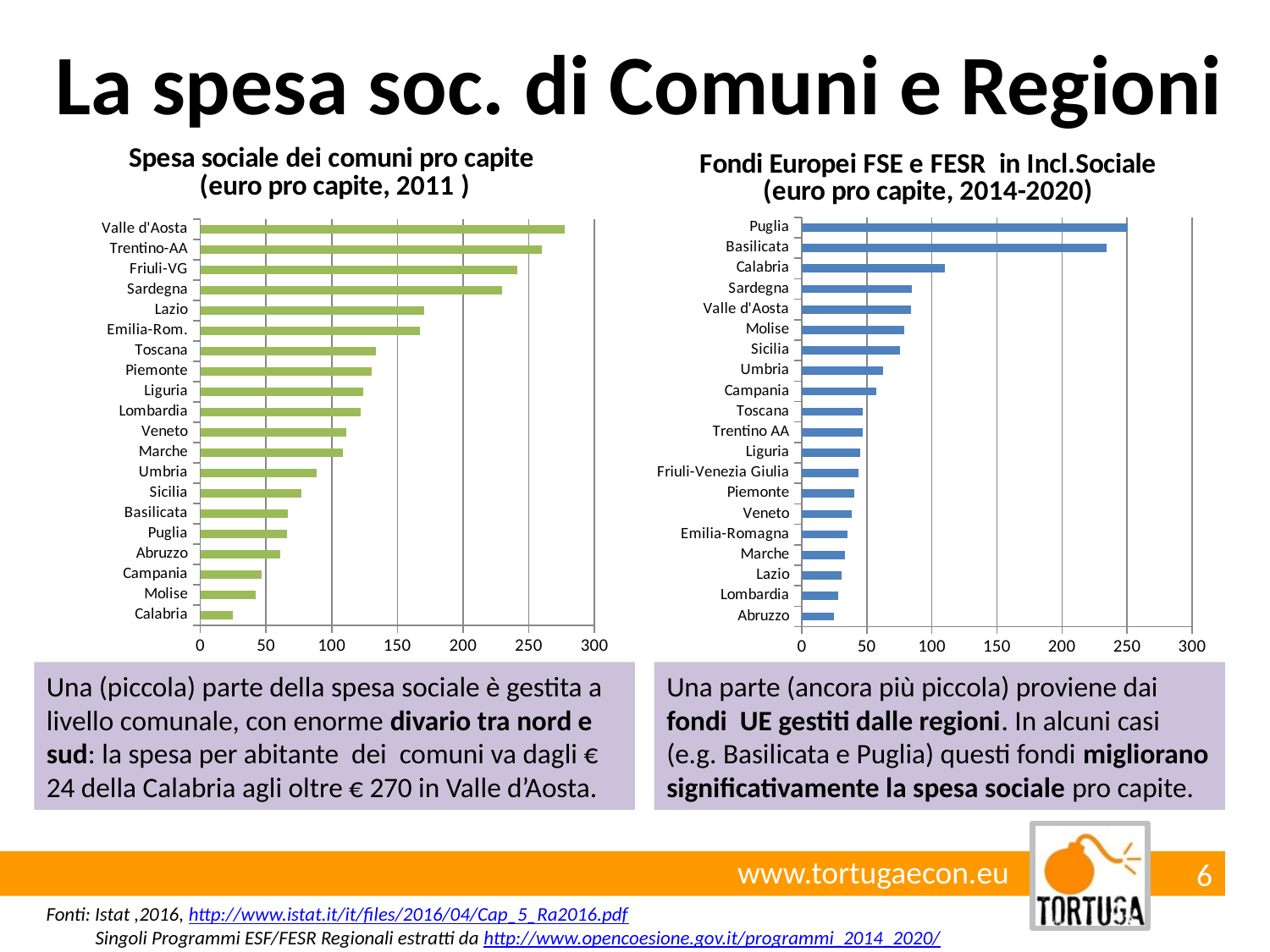
On the left chart (Spesa sociale dei comuni pro capite), which region has the highest value? Valle d'Aosta What kind of chart is the right chart (Fondi Europei FSE e FESR in Incl.Sociale)? Bar chart On the right chart (Fondi Europei FSE e FESR in Incl.Sociale), which region has the highest value? Puglia On the left chart, which has the larger value, Sardegna or Lazio? Sardegna On the right chart, is the value for Calabria greater or less than 100? greater On the left chart, is the value for Valle d'Aosta greater or less than 250? greater On the right chart, which has the larger value, Calabria or Sardegna? Calabria On the right chart (Fondi Europei FSE e FESR in Incl.Sociale), which region has the lowest value? Abruzzo On the right chart, is the value for Basilicata greater or less than 200? greater On the left chart (Spesa sociale dei comuni pro capite), which region has the lowest value? Calabria How many regions are shown on the left chart (Spesa sociale dei comuni pro capite)? 20